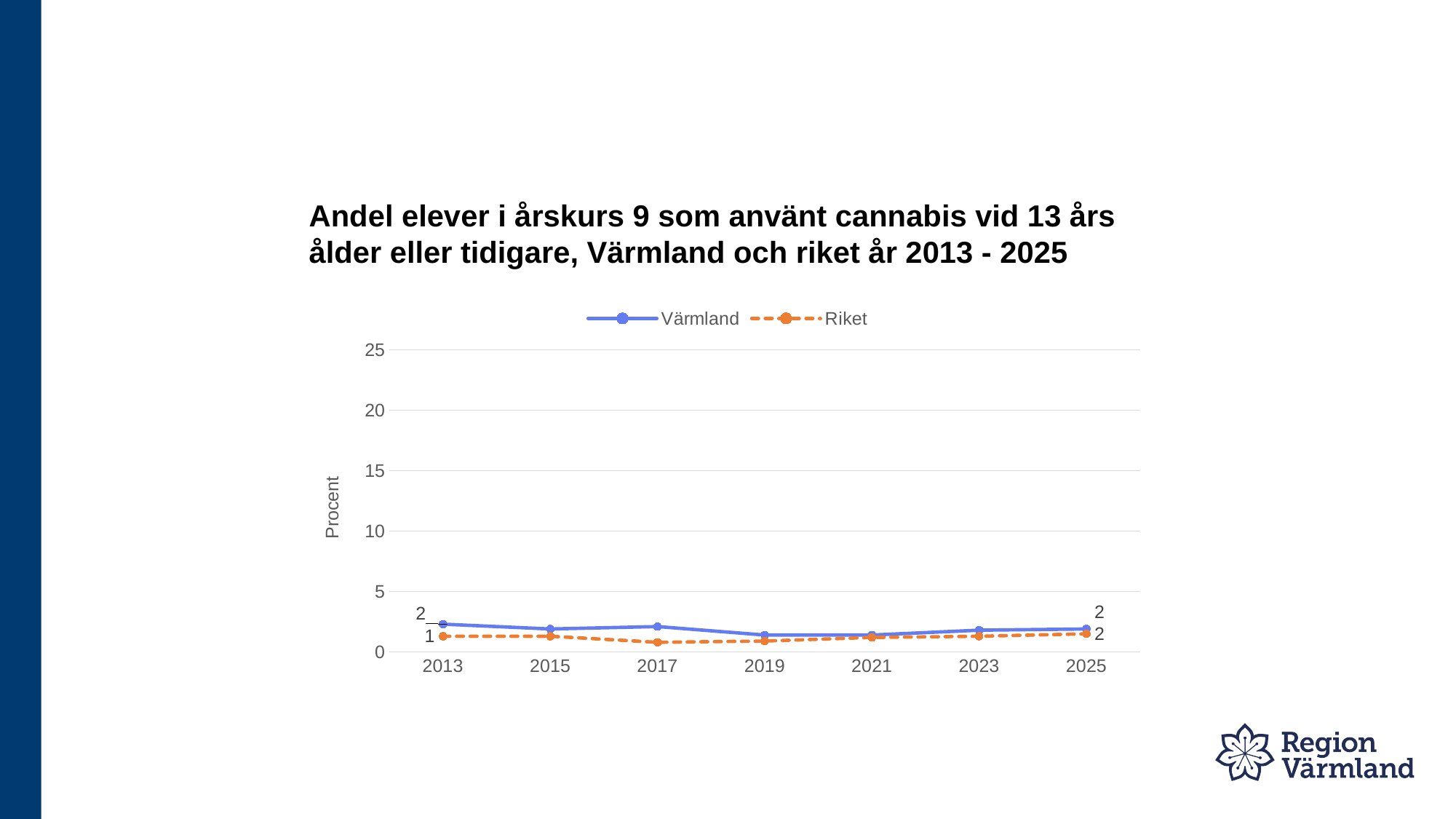
What is the difference between the Värmland and Riket values in 2013? 1 Is the value for Värmland in 2017 greater or less than 5? less How many series does the legend list? 2 Which series has the higher value in 2017, Värmland or Riket? Värmland What is the value for Värmland in 2013? 2 What is the value for Riket in 2025? 2 What is the value for Riket in 2013? 1 How many years are plotted along the x axis? 7 What is the value for Värmland in 2025? 2 Which series has the higher value in 2013, Värmland or Riket? Värmland What type of chart is shown on the slide? Line chart What is the label on the y axis? Procent